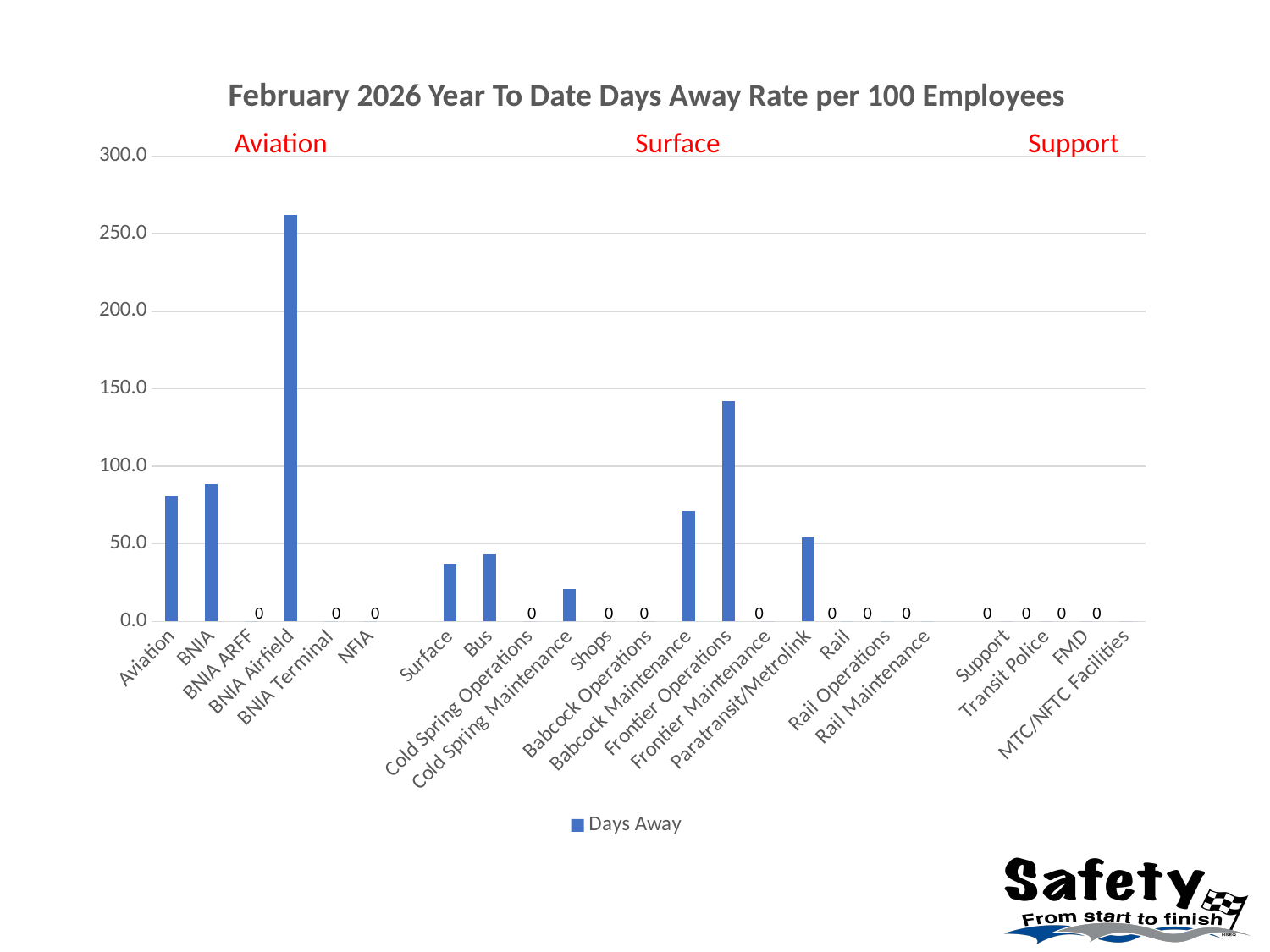
What type of chart is shown on the slide? bar chart Which has a higher Days Away rate, Bus or Cold Spring Maintenance? Bus What is the Days Away rate for BNIA ARFF? 0 Is the value for Frontier Operations greater or less than 150? less What is the Days Away rate for Transit Police? 0 Is the value for Aviation greater or less than 50? greater What is the title of the chart? February 2026 Year To Date Days Away Rate per 100 Employees Is the value for BNIA Airfield greater or less than 250? greater Which has a higher Days Away rate, Frontier Operations or Babcock Maintenance? Frontier Operations How many categories are plotted along the x axis? 23 Which category has the highest Days Away rate? BNIA Airfield How many series does the legend list? 1